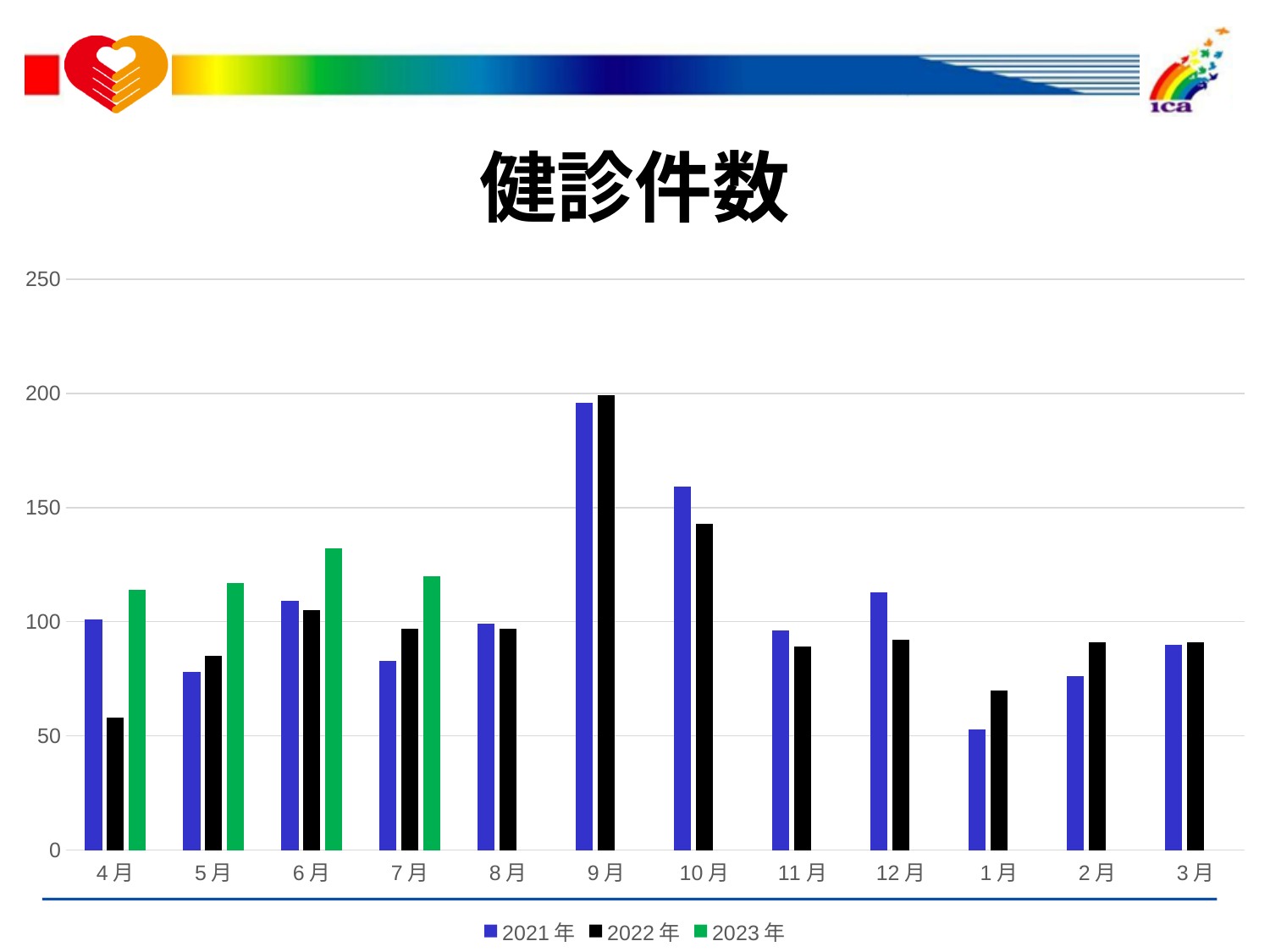
Is the 2022年 value for 4月 greater or less than 50? greater For 1月, which series has the larger value, 2021年 or 2022年? 2022年 In which month is the 2023年 value highest? 6月 In which month is the 2021年 value highest? 9月 What is the title of the chart? 健診件数 What kind of chart is shown on the slide? bar chart Is the 2021年 value for 10月 greater or less than 150? greater How many series does the legend list? 3 For 10月, which series has the larger value, 2021年 or 2022年? 2021年 How many months are shown on the x axis? 12 In which month is the 2022年 value lowest? 4月 In which month is the 2021年 value lowest? 1月